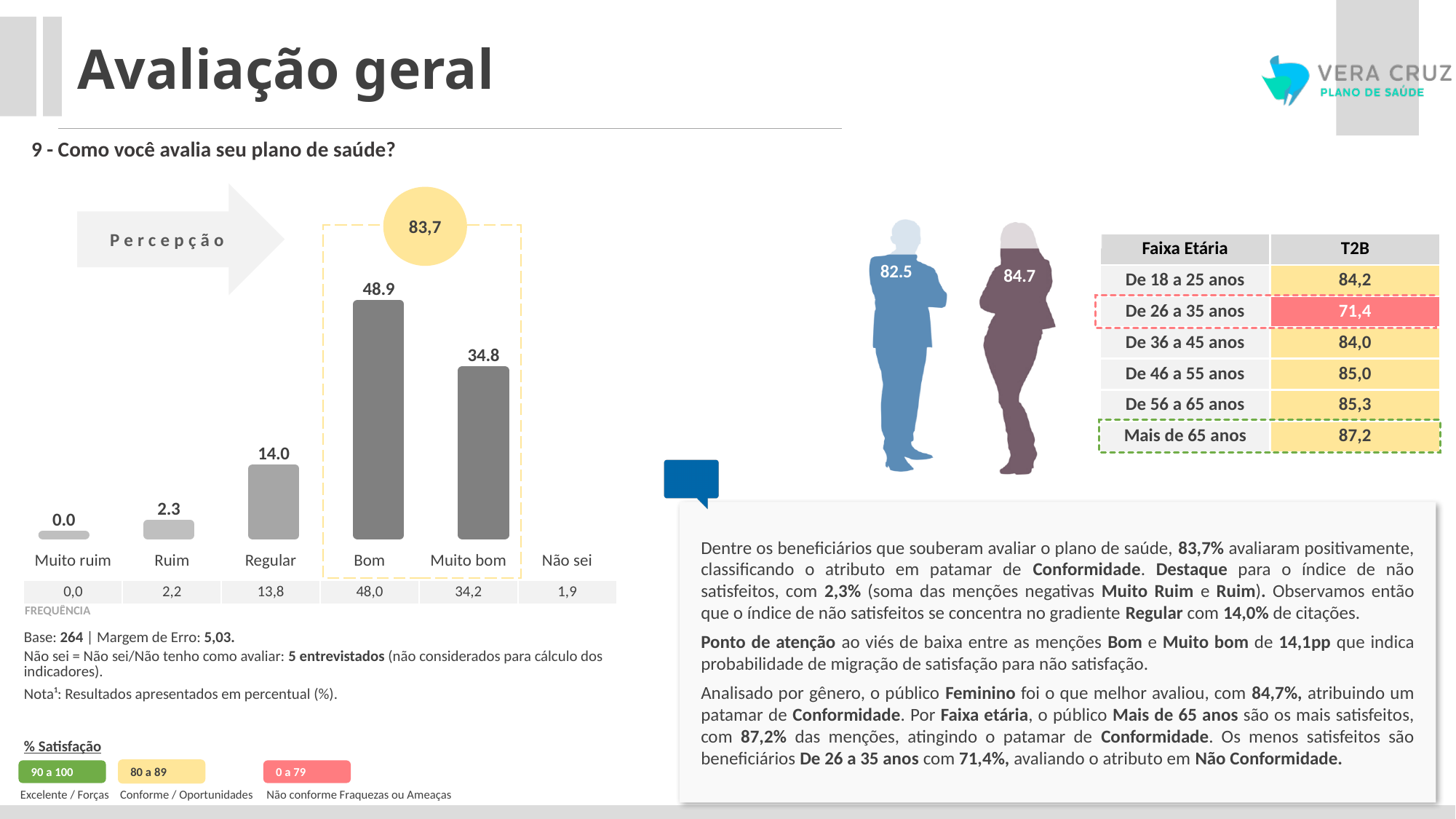
Which category has the lowest value in the chart? Muito ruim What is the value shown for the "Ruim" bar? 2.3 What is the value shown for the "Muito ruim" bar? 0.0 What is the value shown for the "Muito bom" bar? 34.8 What is the value shown for the "Bom" bar? 48.9 Which category has the highest bar in the chart? Bom What is the difference between the values for "Bom" and "Muito bom"? 14.1 What is the value shown for the "Regular" bar? 14.0 What kind of chart is shown under the question "9 - Como você avalia seu plano de saúde?"? bar chart What is the combined value of "Bom" and "Muito bom" shown in the yellow circle above the dashed box? 83,7 What is the difference between the values for "Regular" and "Ruim"? 11.7 Which is larger, the value for "Regular" or the value for "Muito bom"? Muito bom